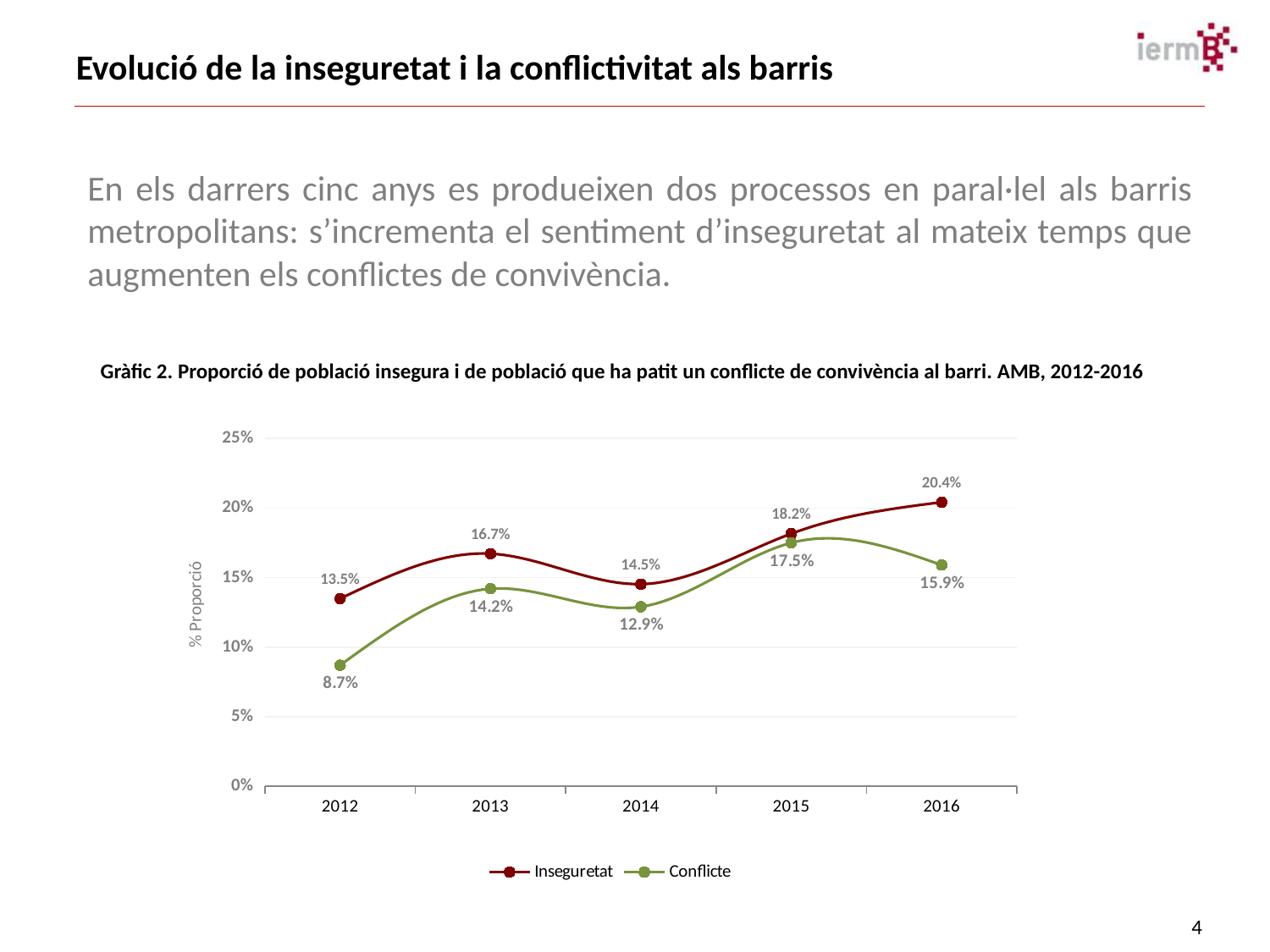
Is the value for Inseguretat in 2016 greater or less than 20%? greater What is the value for Conflicte in 2015? 17.5% What is the value for Conflicte in 2012? 8.7% How many series does the legend list? 2 In which year is Inseguretat highest? 2016 What kind of chart is shown? Line chart Which is larger in 2014, Inseguretat or Conflicte? Inseguretat In which year is Conflicte lowest? 2012 How many years are shown on the x axis? 5 What is the value for Inseguretat in 2016? 20.4% What is the difference between Inseguretat and Conflicte in 2012? 4.8% What is the label of the y axis? % Proporció